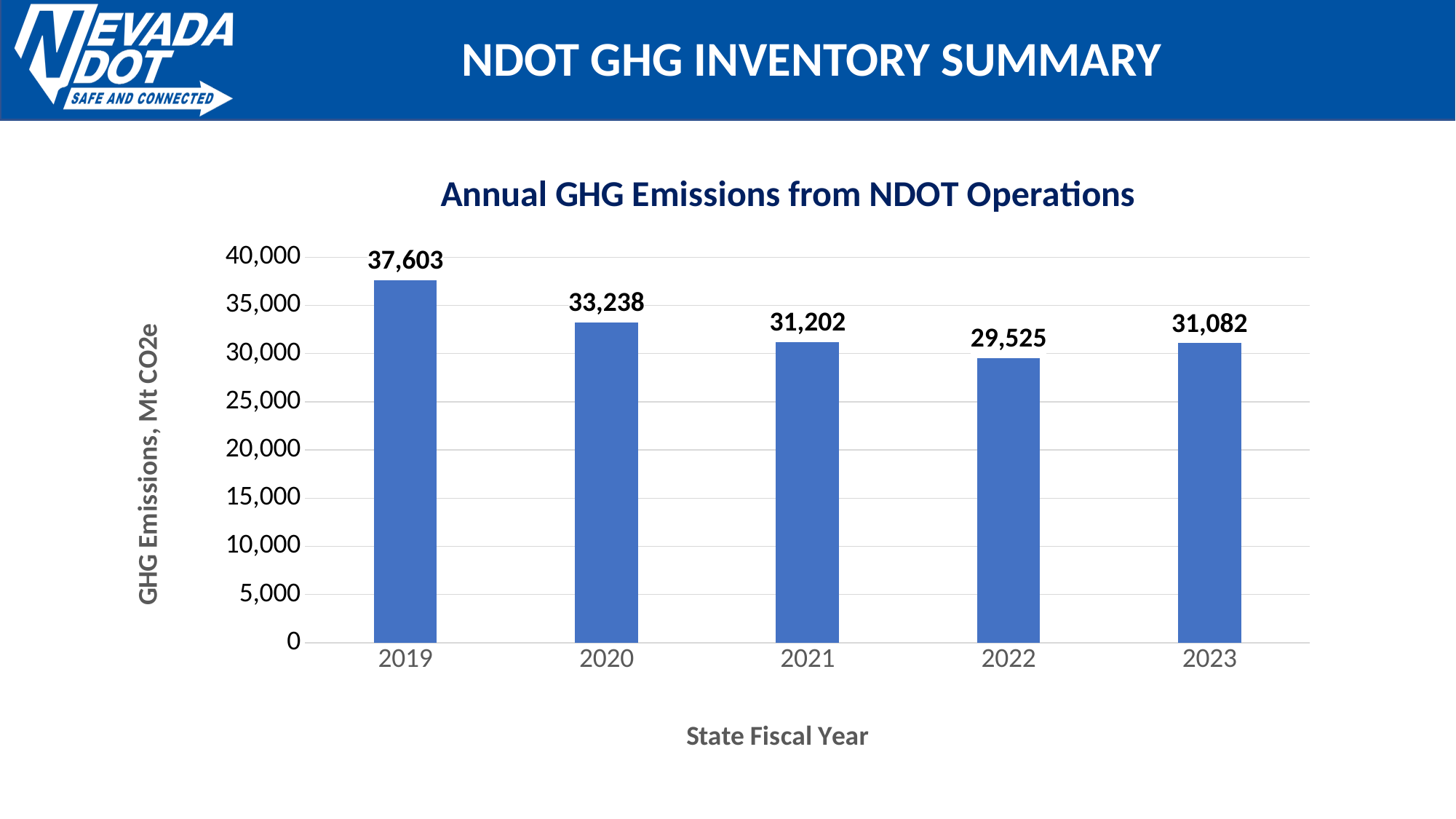
Which year had higher GHG emissions, 2020 or 2021? 2020 What is the difference in GHG emissions between 2021 and 2022? 1,677 What is the difference in GHG emissions between 2019 and 2020? 4,365 Which fiscal year had the lowest GHG emissions? 2022 What is the title of the chart? Annual GHG Emissions from NDOT Operations Is the value for 2022 greater or less than 30,000? less Which fiscal year had the highest GHG emissions? 2019 What kind of chart is shown on the slide? Bar chart What was the GHG emissions value for 2022? 29,525 How many fiscal years are shown on the chart? 5 What was the GHG emissions value for 2023? 31,082 What was the GHG emissions value for 2019? 37,603